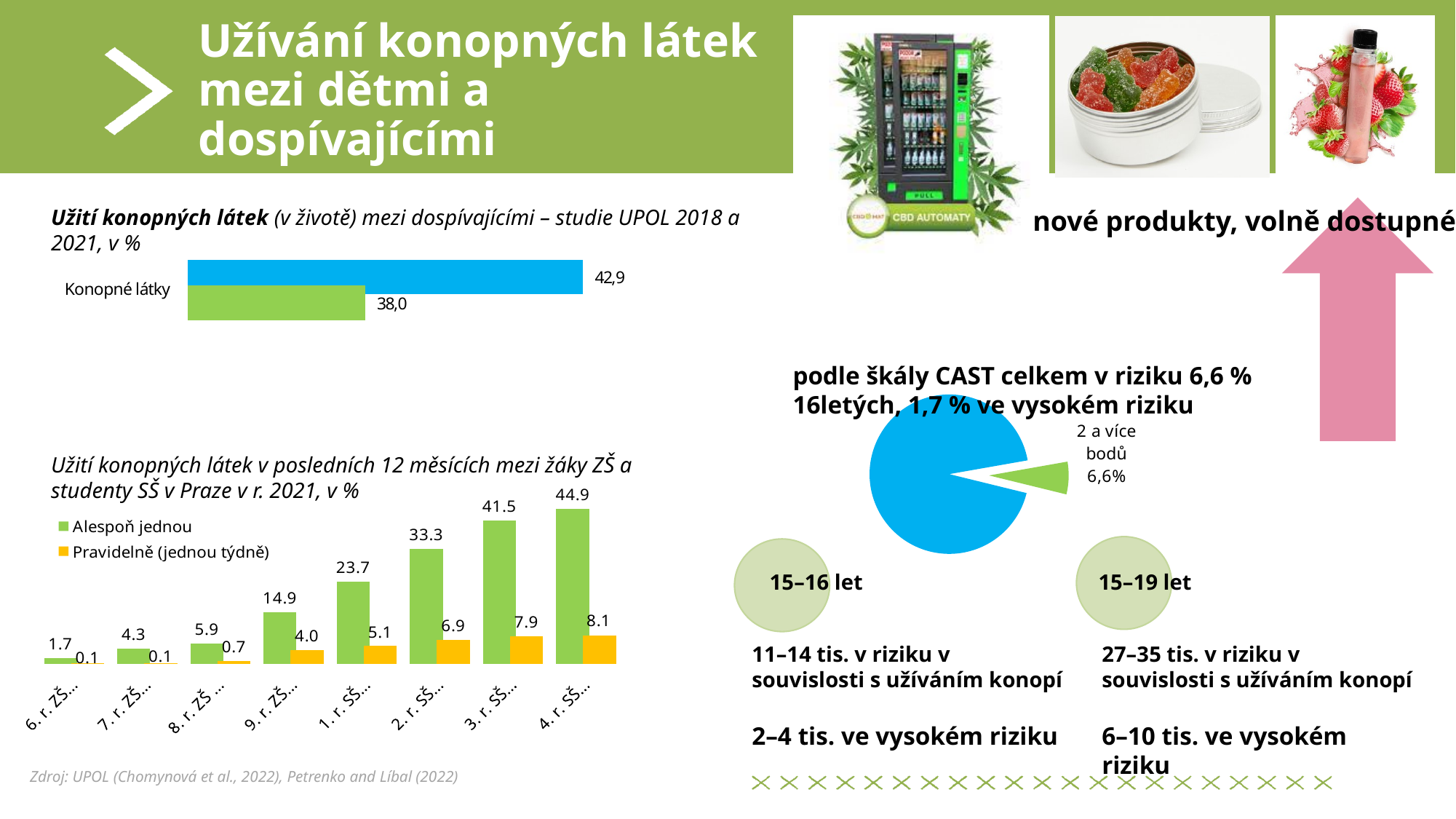
In the top-left chart 'Užití konopných látek (v životě) mezi dospívajícími', what is the value of the green bar for Konopné látky? 38,0 What kind of chart is the top-left chart 'Užití konopných látek (v životě) mezi dospívajícími'? Bar chart In the pie chart on the right, what share is labelled '2 a více bodů'? 6,6% In the top-left chart 'Užití konopných látek (v životě) mezi dospívajícími', what is the difference between the blue bar and the green bar? 4,9 In the bottom-left chart 'Užití konopných látek v posledních 12 měsících', what is the 'Alespoň jednou' value for 4. r. SŠ? 44.9 In the bottom-left chart 'Užití konopných látek v posledních 12 měsících', which category has the lowest 'Alespoň jednou' value? 6. r. ZŠ In the bottom-left chart 'Užití konopných látek v posledních 12 měsících', what is the difference between the 'Alespoň jednou' values for 3. r. SŠ and 2. r. SŠ? 8.2 In the bottom-left chart 'Užití konopných látek v posledních 12 měsících', what is the 'Pravidelně (jednou týdně)' value for 1. r. SŠ? 5.1 In the bottom-left chart 'Užití konopných látek v posledních 12 měsících', do the 'Alespoň jednou' values rise or fall from 6. r. ZŠ to 4. r. SŠ? Rise How many series does the legend of the bottom-left chart 'Užití konopných látek v posledních 12 měsících' list? 2 In the bottom-left chart 'Užití konopných látek v posledních 12 měsících', which category has the highest 'Alespoň jednou' value? 4. r. SŠ In the top-left chart 'Užití konopných látek (v životě) mezi dospívajícími', what is the value of the blue bar for Konopné látky? 42,9